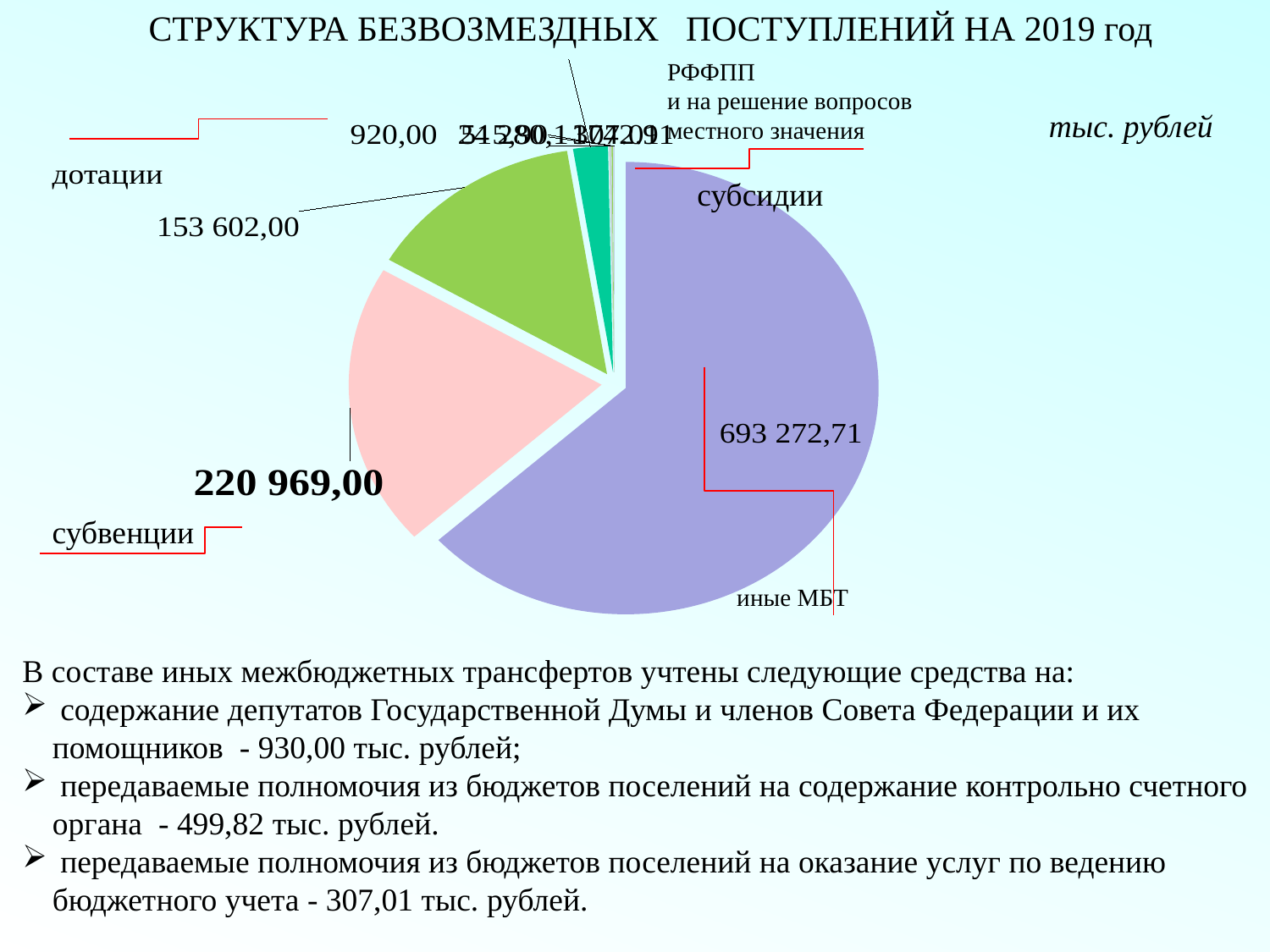
What kind of chart is shown on the slide? pie chart Which category has the largest slice of the pie? субсидии In what units are the values on the chart given? тыс. рублей What is the value for субвенции? 220 969,00 Is the value for дотации greater or less than 200 000? less What is the title of the chart? СТРУКТУРА БЕЗВОЗМЕЗДНЫХ ПОСТУПЛЕНИЙ НА 2019 год What is the difference between субвенции and дотации? 67 367,00 What is the difference between субсидии and субвенции? 472 303,71 What is the value for дотации? 153 602,00 Which is larger, субвенции or дотации? субвенции What is the value for субсидии? 693 272,71